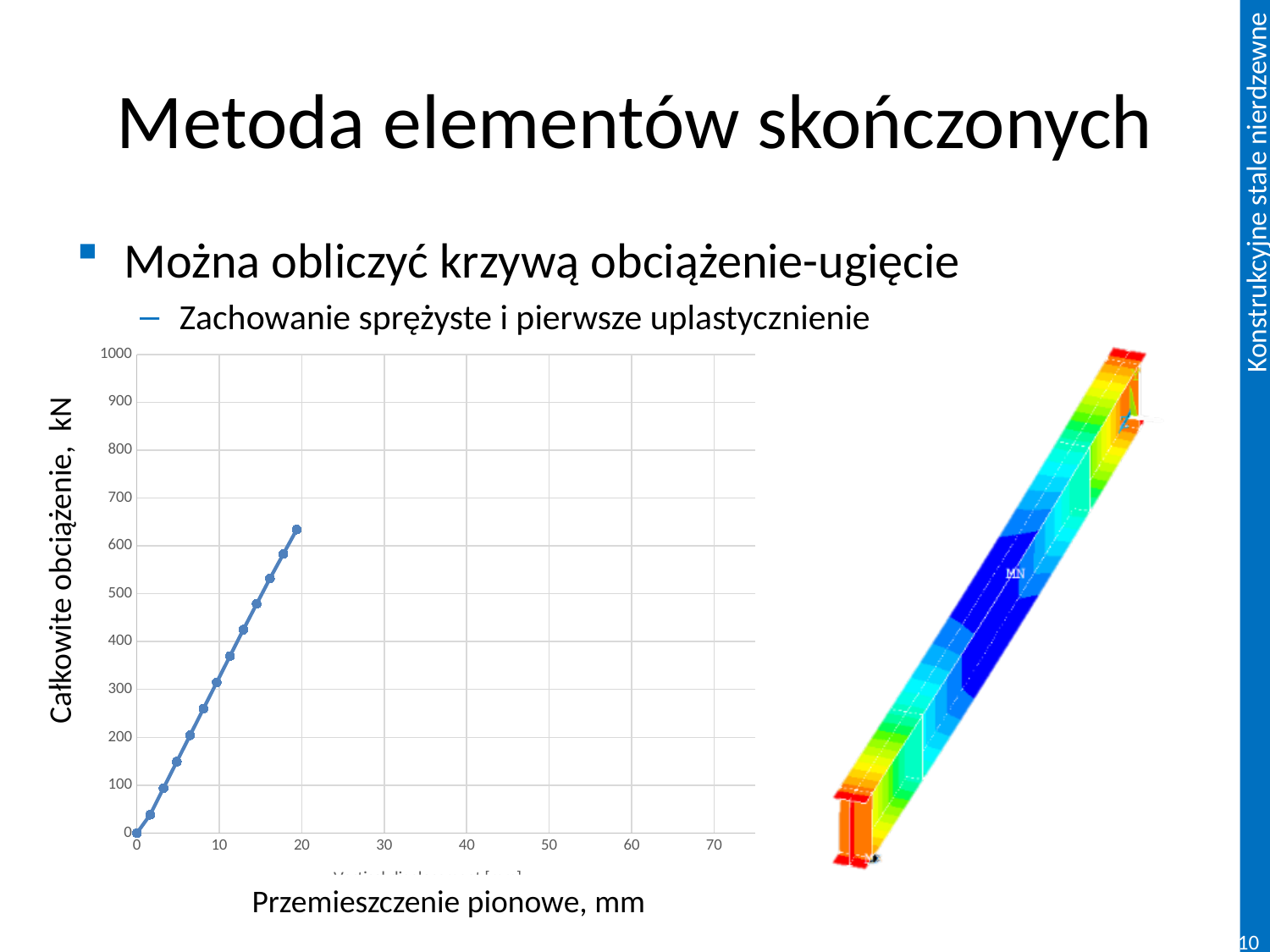
Is the largest plotted vertical displacement greater or less than 30 mm? less Is the highest plotted load value greater or less than 600 kN? greater Is the largest plotted vertical displacement greater or less than 10 mm? greater At what load value does the plotted line start at zero displacement? 0 What is the maximum tick value shown on the x axis of the chart? 70 What is the maximum value shown on the y axis of the chart? 1000 What is the label of the y axis of the chart? Całkowite obciążenie, kN What is the label of the x axis of the chart? Przemieszczenie pionowe, mm What kind of chart is shown on the slide? line chart Does the total load rise or fall as the vertical displacement increases along the x axis? rise